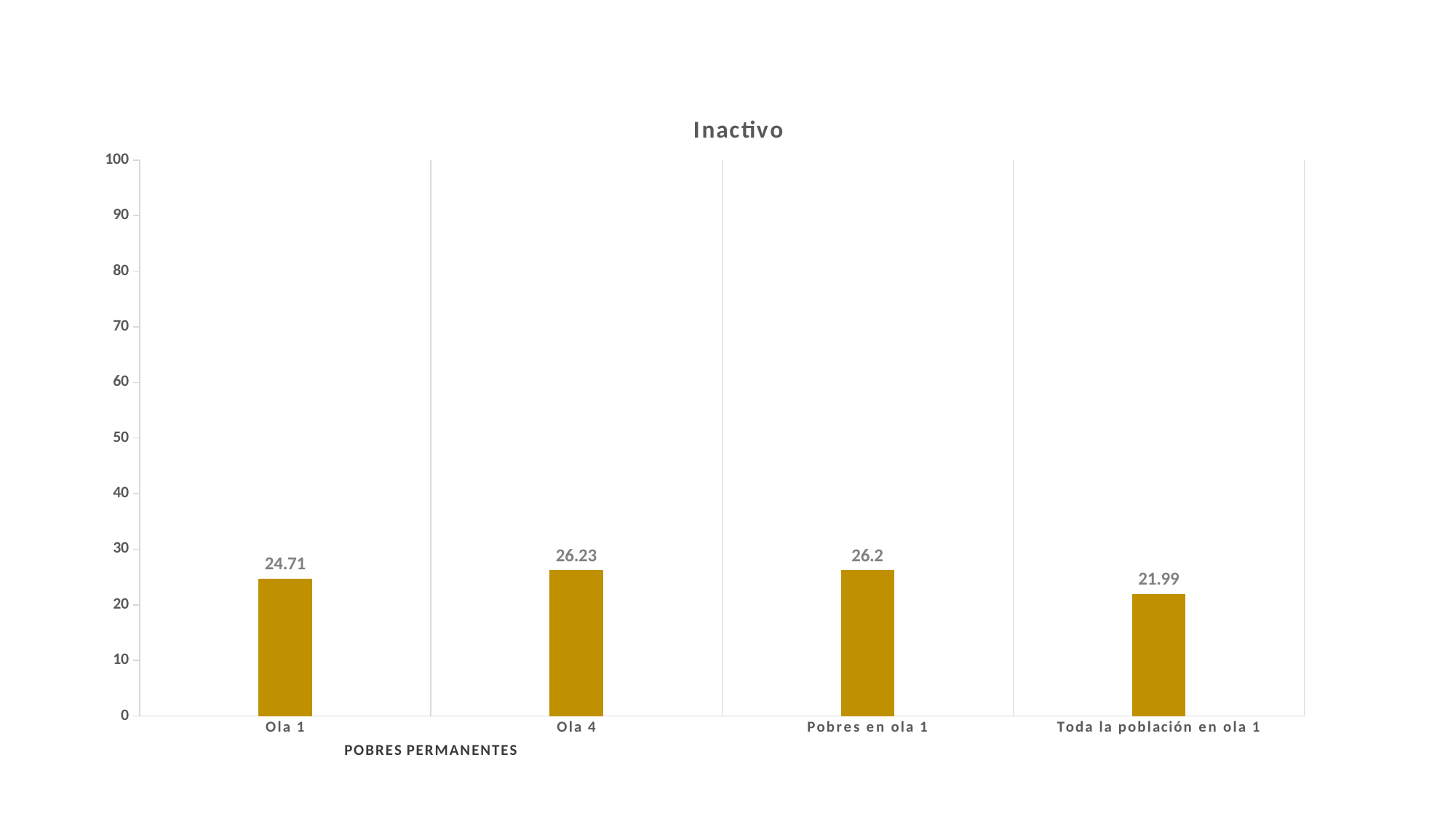
Which is larger, the value for Ola 1 or the value for Toda la población en ola 1? Ola 1 Which category has the lowest value? Toda la población en ola 1 How many categories are shown on the x axis? 4 Is the value for Ola 1 greater or less than 30? less What is the value for Pobres en ola 1? 26.2 What is the difference between the values for Pobres en ola 1 and Toda la población en ola 1? 4.21 What is the value for Ola 1? 24.71 What is the value for Toda la población en ola 1? 21.99 What is the title of the chart? Inactivo What is the value for Ola 4? 26.23 What is the difference between the values for Ola 4 and Ola 1? 1.52 What kind of chart is shown on the slide? bar chart